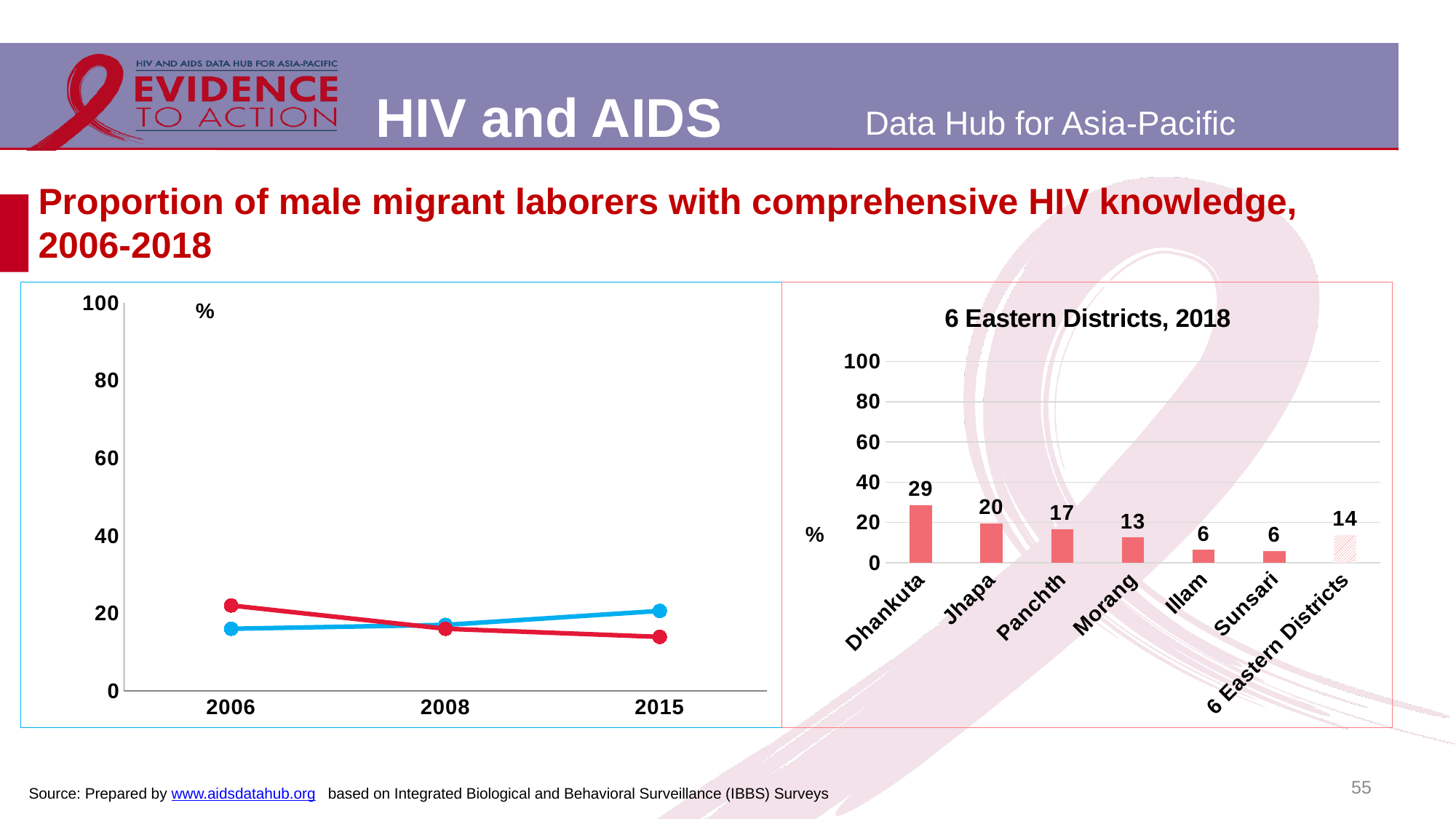
In the chart on the left side of the slide, how many years are shown on the x axis? 3 In the chart titled '6 Eastern Districts, 2018', how many bars are plotted? 7 In the chart titled '6 Eastern Districts, 2018', what is the value for the '6 Eastern Districts' bar? 14 What kind of chart is the chart on the left side of the slide? Line chart What kind of chart is the chart titled '6 Eastern Districts, 2018'? Bar chart In the chart titled '6 Eastern Districts, 2018', which is larger, the value for Jhapa or the value for Morang? Jhapa In the chart titled '6 Eastern Districts, 2018', which district has the highest value? Dhankuta In the chart on the left side of the slide, is the value of the blue line in 2015 greater or less than 40? less In the chart titled '6 Eastern Districts, 2018', what is the value for Morang? 13 In the chart titled '6 Eastern Districts, 2018', what is the difference between the values for Dhankuta and Jhapa? 9 In the chart titled '6 Eastern Districts, 2018', what is the value for Dhankuta? 29 In the chart on the left side of the slide, does the red line rise or fall from 2006 to 2015? Fall